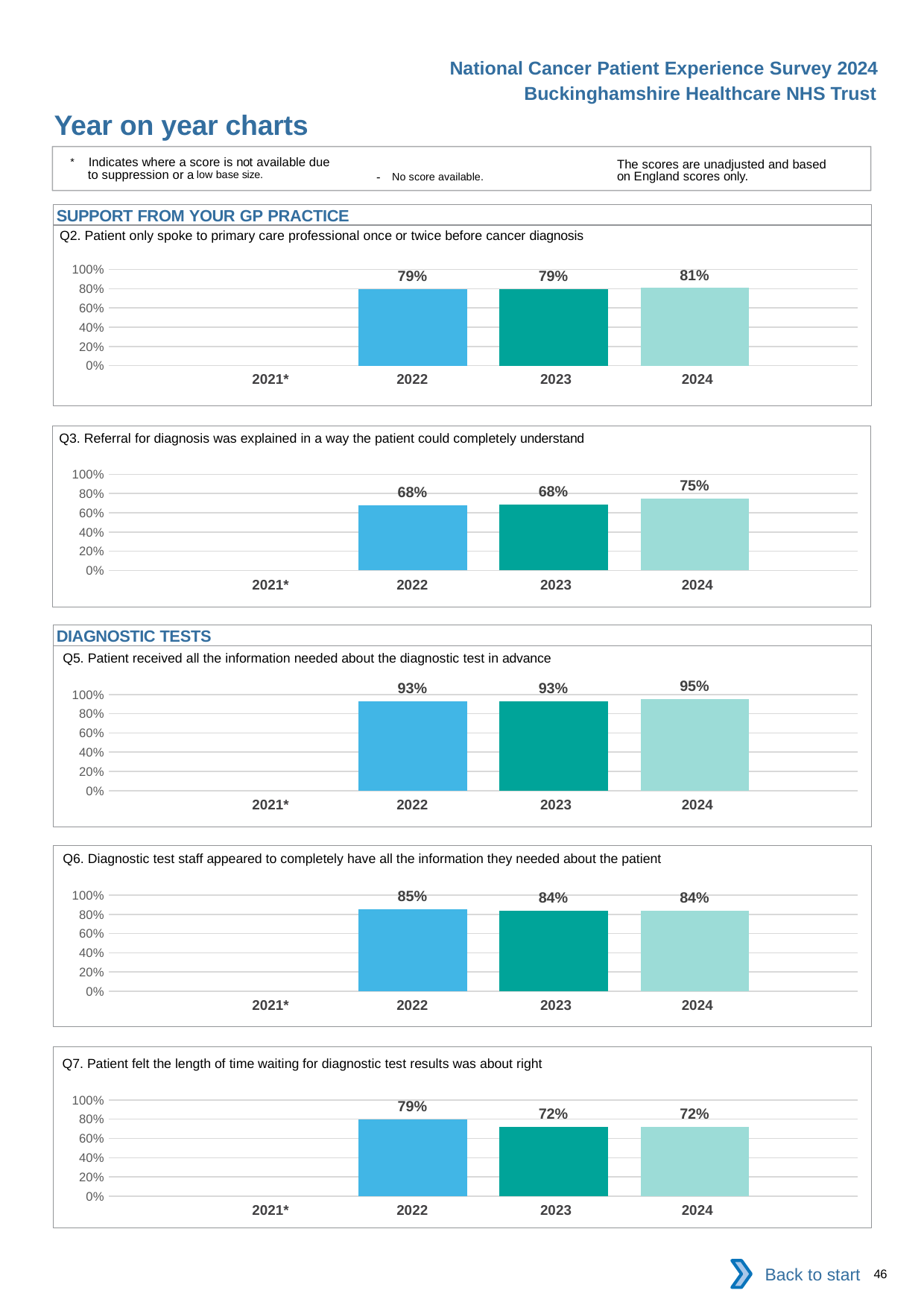
In the Q2 chart, what is the value for 2024? 81% In the Q2 chart, how many years are shown on the x axis? 4 In the Q3 chart, what is the value for 2022? 68% In the Q3 chart, which year has the highest value? 2024 In the Q5 chart, what is the value for 2024? 95% In the Q7 chart, do the values rise or fall from 2022 to 2023? Fall In the Q6 chart, which year has the highest value? 2022 In the Q7 chart, is the value for 2022 larger than the value for 2023? Yes In the Q7 chart, what is the difference between the 2022 and 2024 values? 7% In the Q7 chart, what is the value for 2022? 79% In the Q3 chart, what is the difference between the 2024 and 2023 values? 7% What kind of chart is the Q5 chart? Bar chart